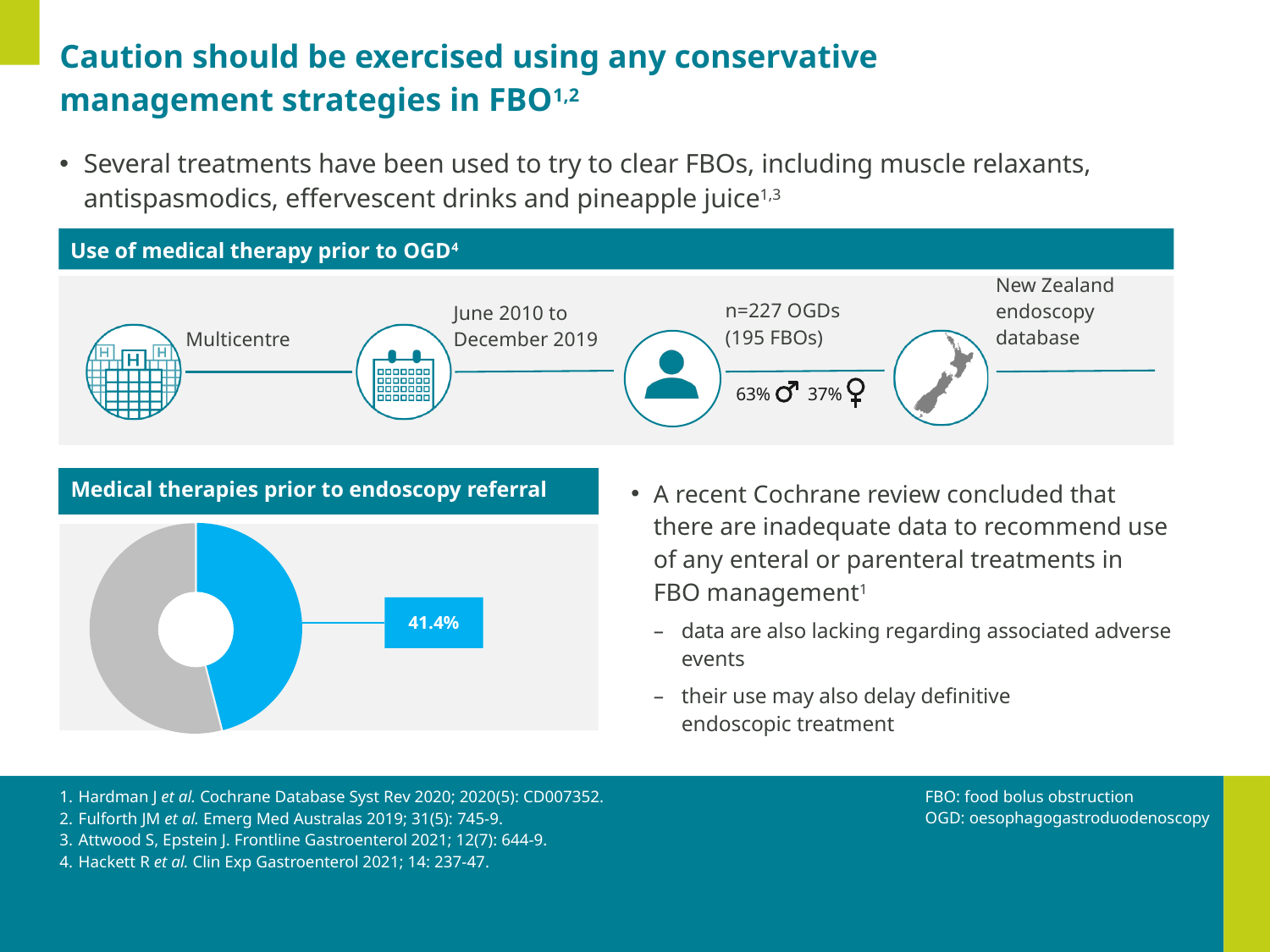
What colour is the slice labelled 41.4% in the 'Medical therapies prior to endoscopy referral' chart? Blue In the 'Medical therapies prior to endoscopy referral' chart, which slice is larger, the blue one or the grey one? The grey one In the 'Medical therapies prior to endoscopy referral' chart, what value is printed for the blue slice? 41.4% How many slices does the 'Medical therapies prior to endoscopy referral' chart have? 2 In the 'Medical therapies prior to endoscopy referral' chart, is the blue slice greater or less than 50% of the whole? less What share of the 'Medical therapies prior to endoscopy referral' chart does the labelled slice represent? 41.4% What kind of chart is shown under the heading 'Medical therapies prior to endoscopy referral'? Pie (donut) chart In the 'Medical therapies prior to endoscopy referral' chart, is the grey slice greater or less than 50% of the whole? greater What is the title of the chart on the lower left of the slide? Medical therapies prior to endoscopy referral Which slice in the 'Medical therapies prior to endoscopy referral' chart is the smallest? The blue slice (41.4%)